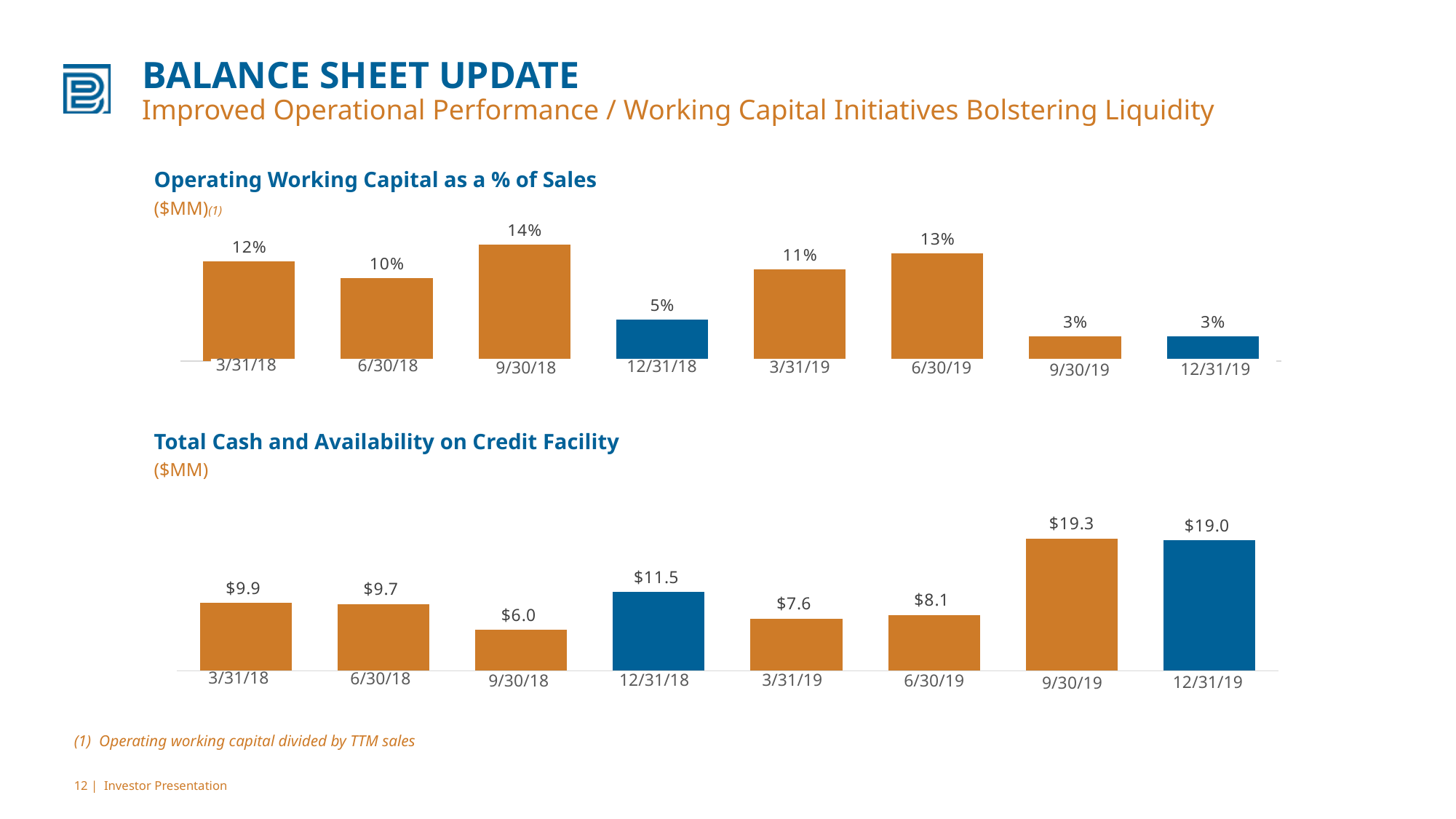
In the 'Total Cash and Availability on Credit Facility' chart, what is the value for 9/30/19? $19.3 In the 'Operating Working Capital as a % of Sales' chart, what is the difference between the values for 6/30/19 and 9/30/19? 10% In the 'Total Cash and Availability on Credit Facility' chart, what unit is shown below the chart title? ($MM) In the 'Total Cash and Availability on Credit Facility' chart, what is the value for 6/30/19? $8.1 In the 'Total Cash and Availability on Credit Facility' chart, which period has the lowest value? 9/30/18 In the 'Operating Working Capital as a % of Sales' chart, which period has the highest value? 9/30/18 In the 'Operating Working Capital as a % of Sales' chart, what is the value for 12/31/18? 5% In the 'Operating Working Capital as a % of Sales' chart, what is the value for 9/30/18? 14% In the 'Total Cash and Availability on Credit Facility' chart, which is larger, the value for 12/31/18 or the value for 3/31/19? 12/31/18 What kind of chart is the 'Total Cash and Availability on Credit Facility' chart? Bar chart In the 'Total Cash and Availability on Credit Facility' chart, what is the difference between the values for 9/30/19 and 12/31/19? $0.3 In the 'Operating Working Capital as a % of Sales' chart, how many periods are shown? 8